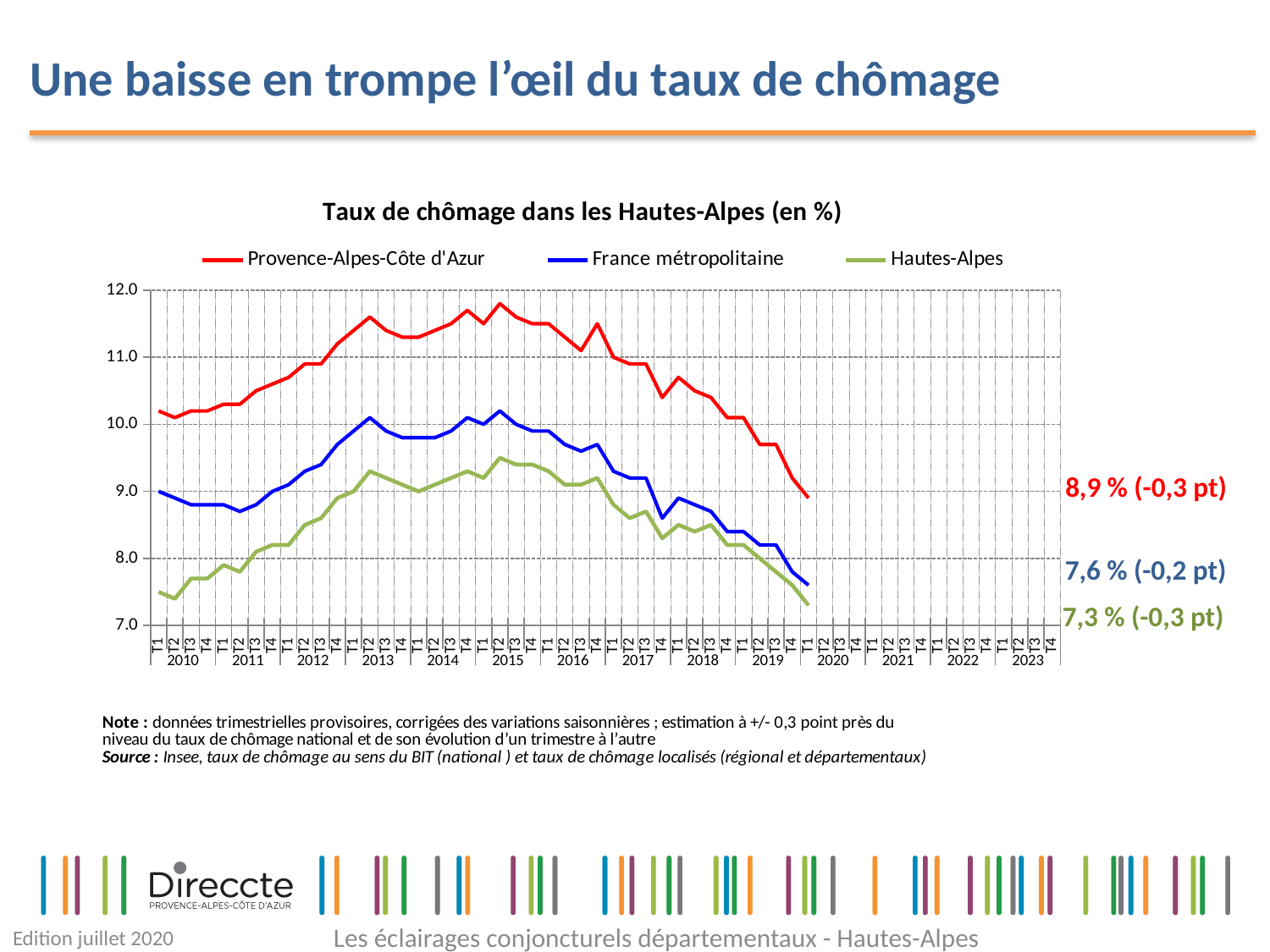
What is the latest unemployment rate shown for Hautes-Alpes? 7,3 % Is the value for Provence-Alpes-Côte d'Azur in T1 2010 greater or less than 10.0? greater How many series does the legend list? 3 What is the latest unemployment rate shown for Provence-Alpes-Côte d'Azur? 8,9 % Is the value for Hautes-Alpes in T1 2010 greater or less than 8.0? less What is the difference between the latest rates for France métropolitaine and Hautes-Alpes? 0,3 points What kind of chart is shown on the slide? Line chart Which series has the highest unemployment rate across the whole period? Provence-Alpes-Côte d'Azur What is the difference between the latest rates for Provence-Alpes-Côte d'Azur and Hautes-Alpes? 1,6 points By how many points did the Hautes-Alpes unemployment rate change in the latest quarter, according to the label? -0,3 pt What is the latest unemployment rate shown for France métropolitaine? 7,6 % Which series has the lowest unemployment rate across the whole period? Hautes-Alpes